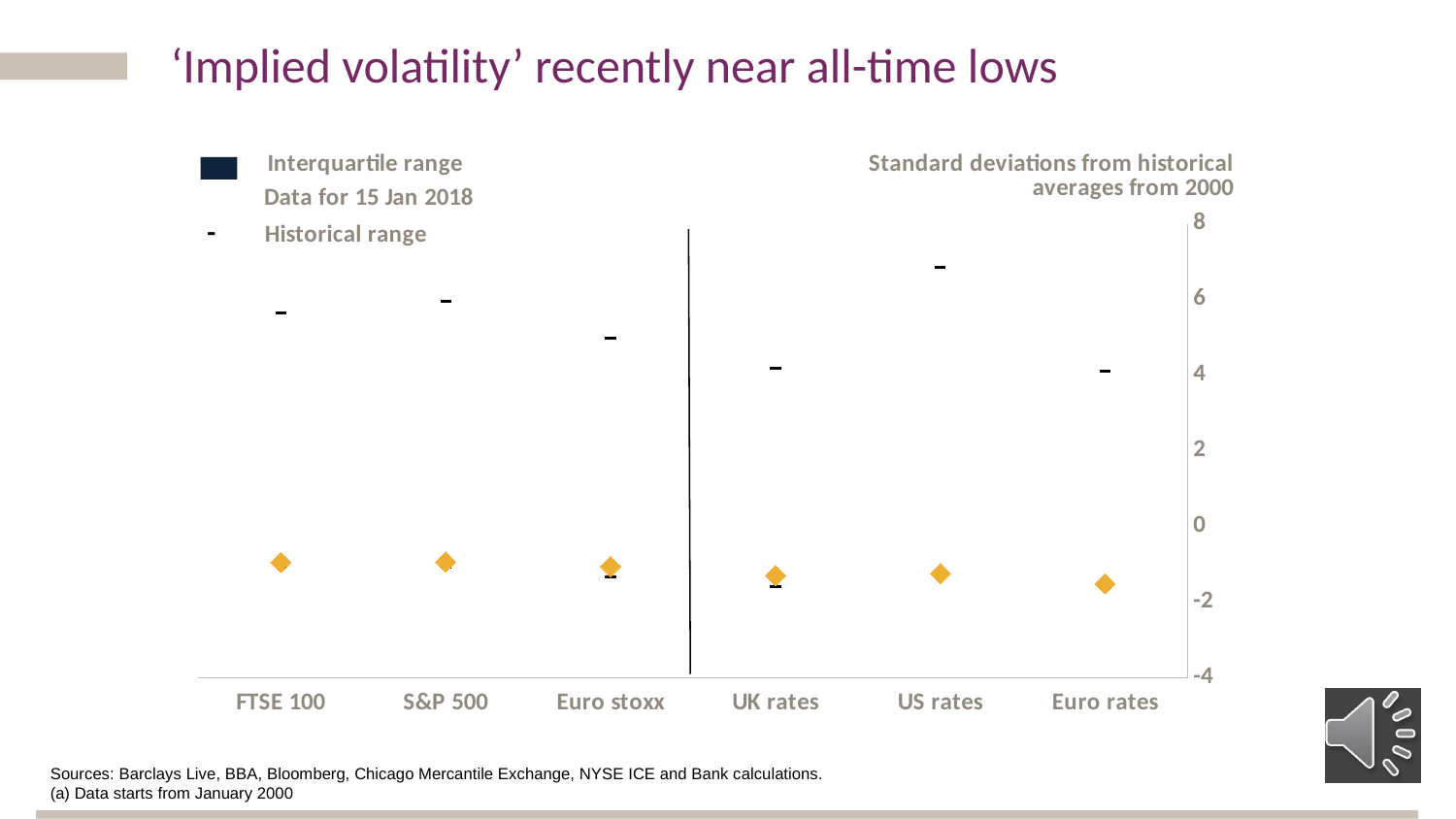
Which category has the highest upper historical range marker? US rates Which is larger: the upper historical range marker for S&P 500 or for UK rates? S&P 500 What kind of chart is shown on the slide? scatter chart Is the upper historical range marker for US rates greater or less than 6? greater Is the 15 Jan 2018 value for FTSE 100 greater or less than 0? less How many categories are shown on the x axis of the chart? 6 How many entries does the chart's legend list? 3 What date does the diamond marker in the legend represent? 15 Jan 2018 Is the upper historical range marker for Euro stoxx greater or less than 4? greater What is the title shown above the chart's y axis? Standard deviations from historical averages from 2000